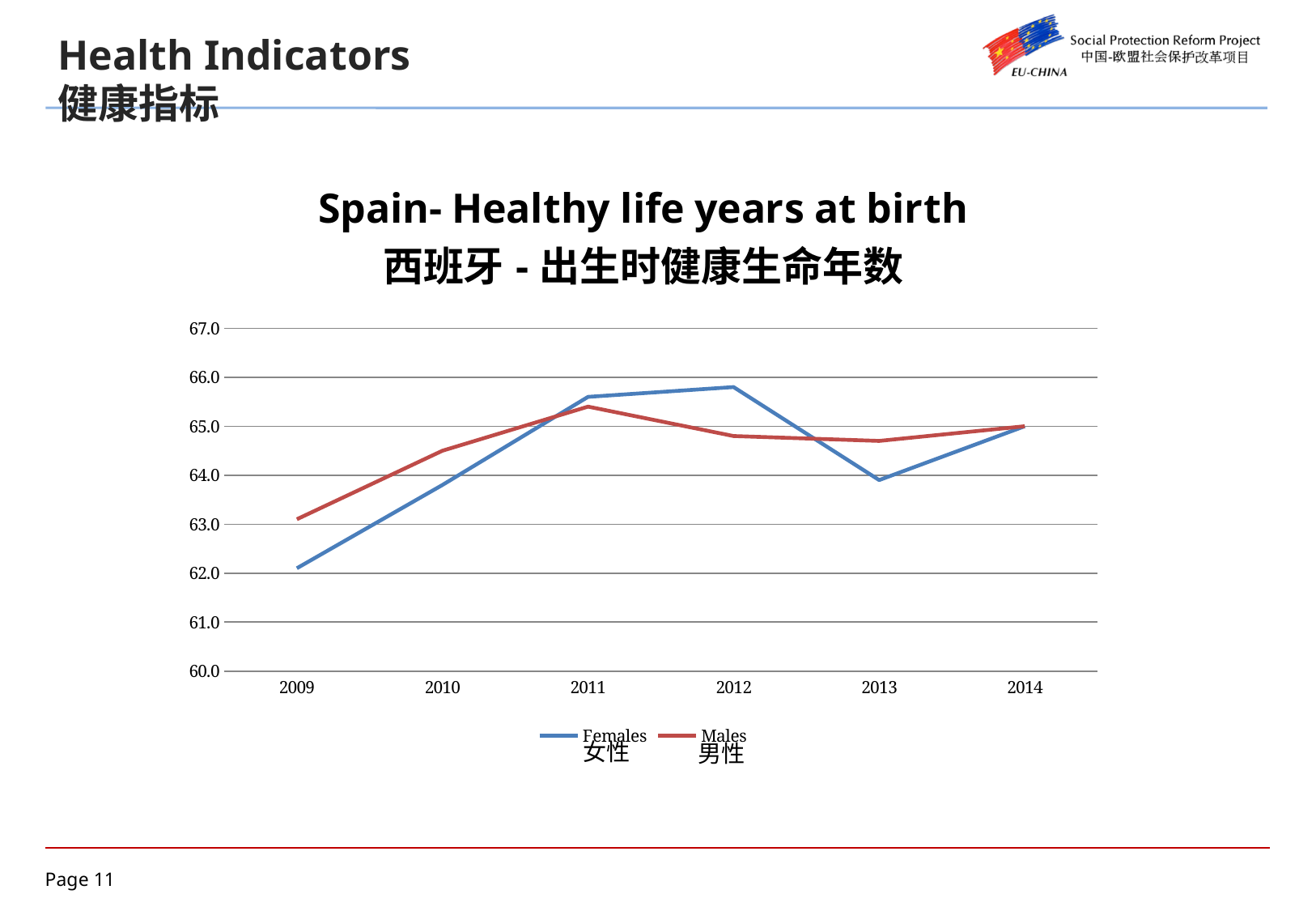
In 2012, which series has the higher value, Females or Males? Females Is the value for Males in 2010 greater or less than 64.0? greater How many series does the legend list? 2 Is the value for Females in 2013 greater or less than 65.0? less How many years are shown on the x axis? 6 Is the value for Males in 2009 greater or less than 64.0? less What kind of chart is shown on the slide? line chart In 2009, which series has the higher value, Females or Males? Males In which year is the Females value lowest? 2009 In which year is the Males value highest? 2011